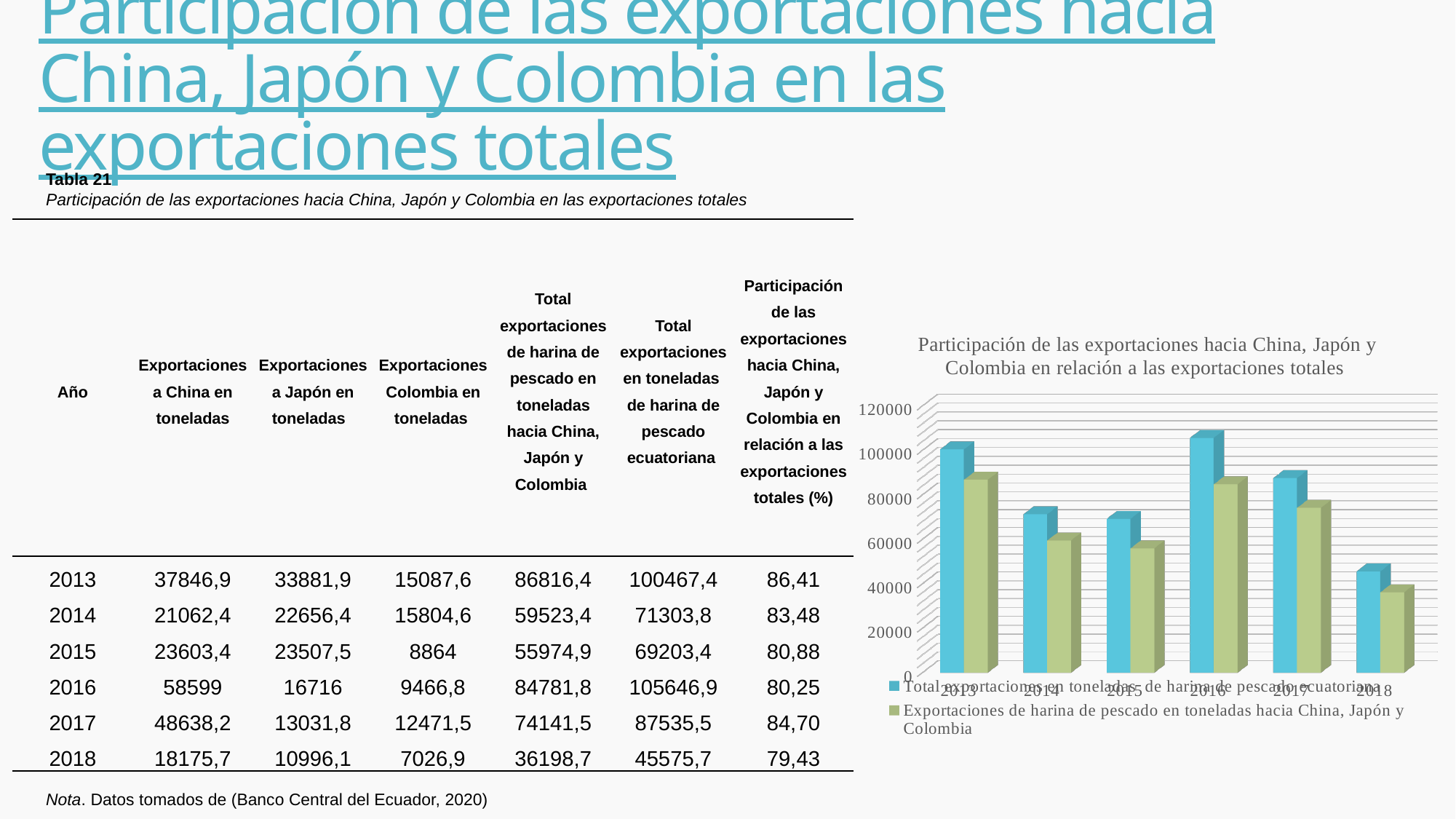
In which year is the value for 'Exportaciones de harina de pescado en toneladas hacia China, Japón y Colombia' lowest? 2018 Which colour represents 'Total exportaciones en toneladas de harina de pescado ecuatoriana' in the chart? blue In which year is the value for 'Total exportaciones en toneladas de harina de pescado ecuatoriana' highest? 2016 Which is larger: the 2017 or the 2014 value for 'Total exportaciones en toneladas de harina de pescado ecuatoriana'? 2017 In which year is the value for 'Total exportaciones en toneladas de harina de pescado ecuatoriana' lowest? 2018 Is the 2017 value for 'Exportaciones de harina de pescado en toneladas hacia China, Japón y Colombia' greater or less than 60000? greater What kind of chart is shown on the right of the slide? bar chart According to the table on the slide, what is the value of 'Total exportaciones en toneladas de harina de pescado ecuatoriana' for 2016? 105646,9 Do the values for 'Total exportaciones en toneladas de harina de pescado ecuatoriana' rise or fall from 2016 to 2018? fall Is the 2016 value for 'Total exportaciones en toneladas de harina de pescado ecuatoriana' greater or less than 100000? greater How many years are shown on the x axis of the chart? 6 How many series does the chart legend list? 2